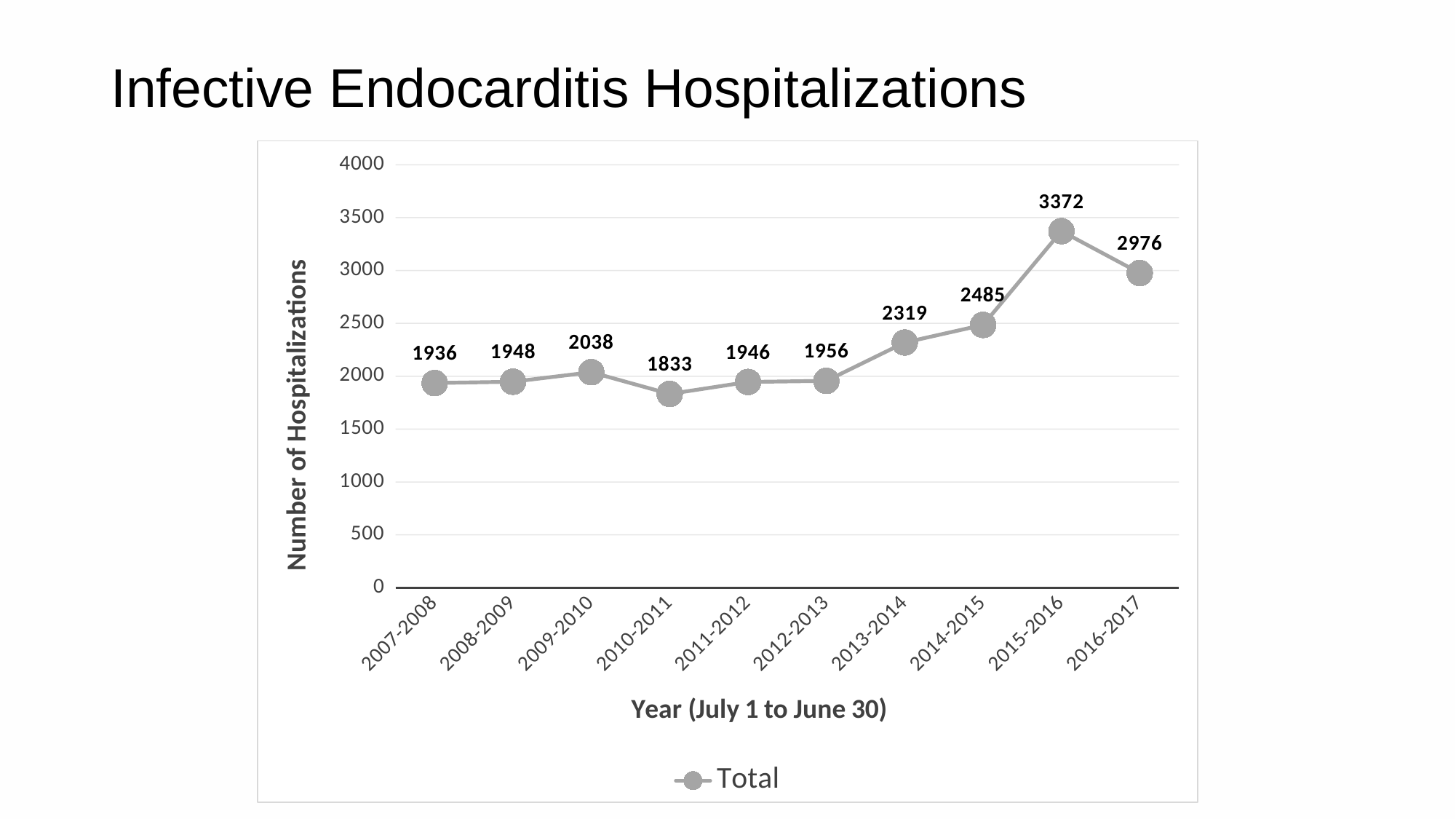
Which year has the lowest number of hospitalizations? 2010-2011 What kind of chart is shown on the slide? line chart What is the number of hospitalizations for 2010-2011? 1833 How many years are plotted on the x axis? 10 Which year has more hospitalizations, 2013-2014 or 2014-2015? 2014-2015 Which year has the highest number of hospitalizations? 2015-2016 What is the difference in hospitalizations between 2015-2016 and 2016-2017? 396 Is the value for 2014-2015 greater or less than 2000? greater What is the number of hospitalizations for 2015-2016? 3372 How many series does the legend list? 1 What is the number of hospitalizations for 2016-2017? 2976 What is the label of the y axis? Number of Hospitalizations